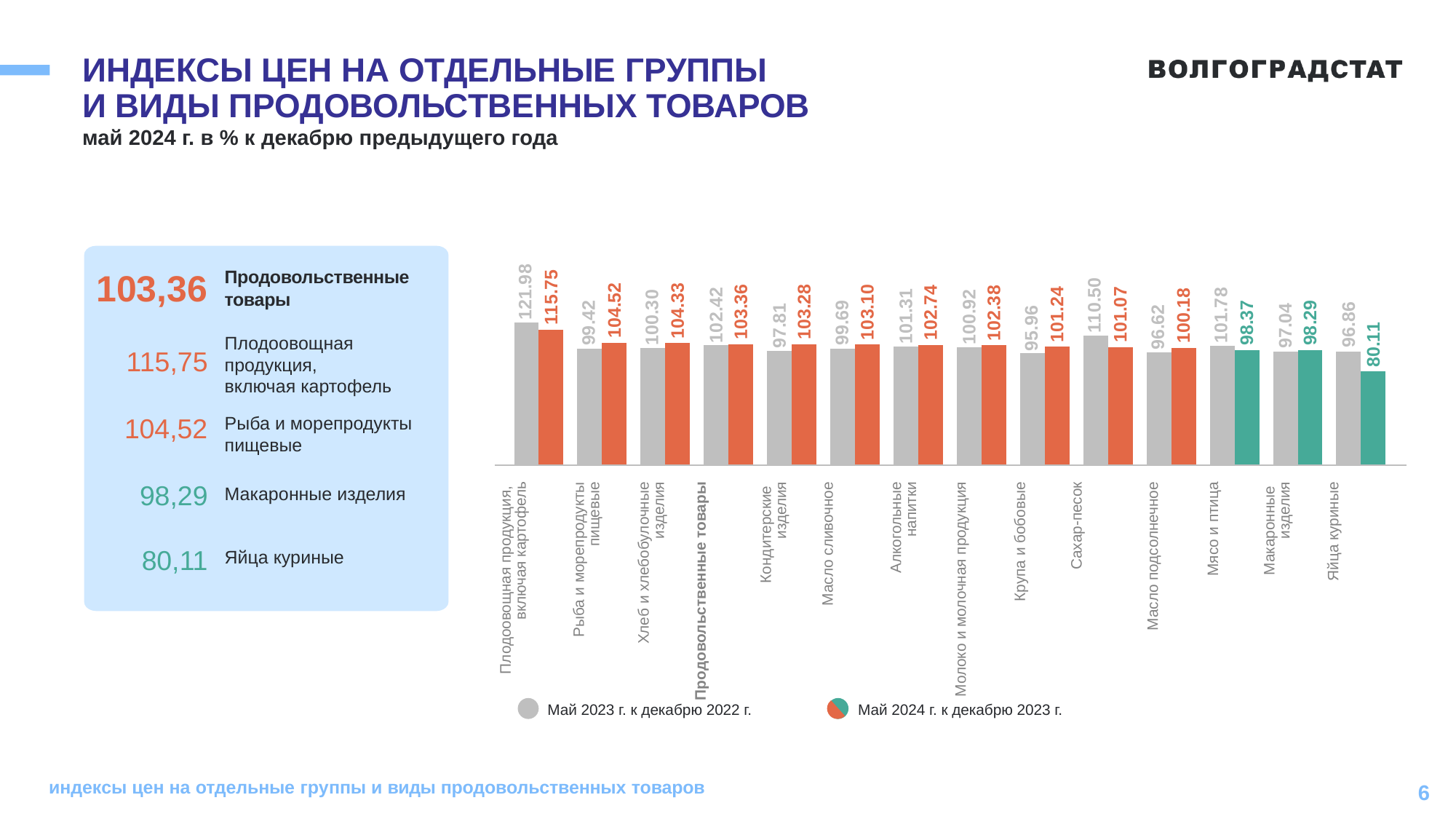
What type of chart is shown on the slide? Bar chart What is the difference between the 'Май 2024 г. к декабрю 2023 г.' values for Плодоовощная продукция, включая картофель and Рыба и морепродукты пищевые? 11.23 What colour are the 'Май 2024 г. к декабрю 2023 г.' bars for categories whose value is below 100? Green What is the value for Сахар-песок in the series 'Май 2023 г. к декабрю 2022 г.'? 110.50 Which category has the lowest value in the series 'Май 2023 г. к декабрю 2022 г.'? Крупа и бобовые How many series does the chart legend list? 2 What is the value for Кондитерские изделия in the series 'Май 2024 г. к декабрю 2023 г.'? 103.28 What is the value for Яйца куриные in the series 'Май 2024 г. к декабрю 2023 г.'? 80.11 How many categories are shown on the x axis of the chart? 14 For Мясо и птица, which series has the larger value: 'Май 2023 г. к декабрю 2022 г.' or 'Май 2024 г. к декабрю 2023 г.'? Май 2023 г. к декабрю 2022 г. Which category has the highest value in the series 'Май 2024 г. к декабрю 2023 г.'? Плодоовощная продукция, включая картофель What is the difference between the 'Май 2023 г. к декабрю 2022 г.' and 'Май 2024 г. к декабрю 2023 г.' values for Сахар-песок? 9.43